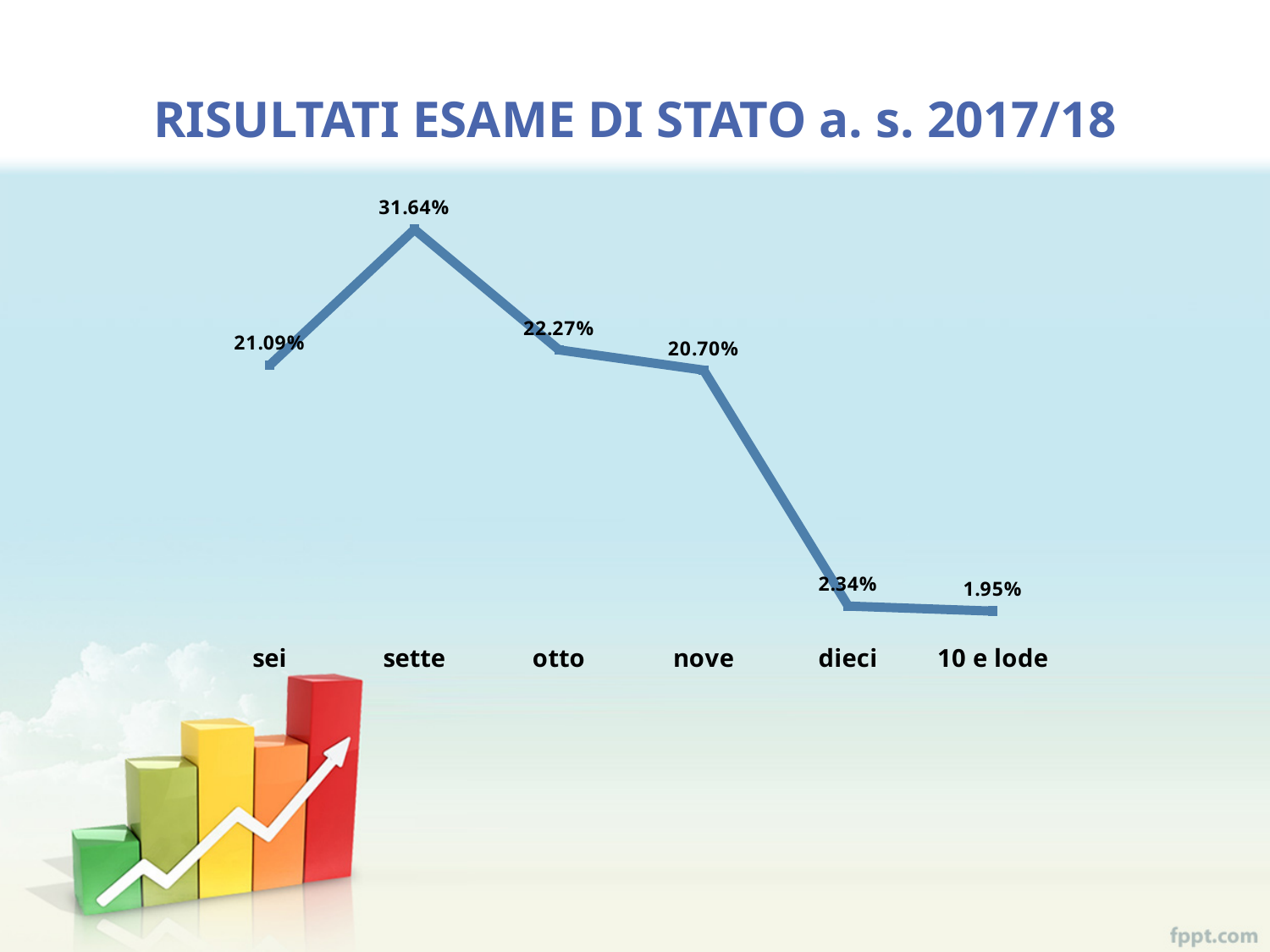
What is the value for "10 e lode"? 1.95% Which category has the lowest value? 10 e lode How many categories are plotted on the x axis? 6 What is the value for "dieci"? 2.34% What is the value for "sette"? 31.64% What is the difference between the values for "nove" and "dieci"? 18.36% Which category has the highest value? sette What kind of chart is shown on the slide? line chart What is the value for "sei"? 21.09% Which is larger, the value for "otto" or the value for "nove"? otto What is the title of the slide containing the chart? RISULTATI ESAME DI STATO a. s. 2017/18 What is the difference between the values for "sette" and "otto"? 9.37%